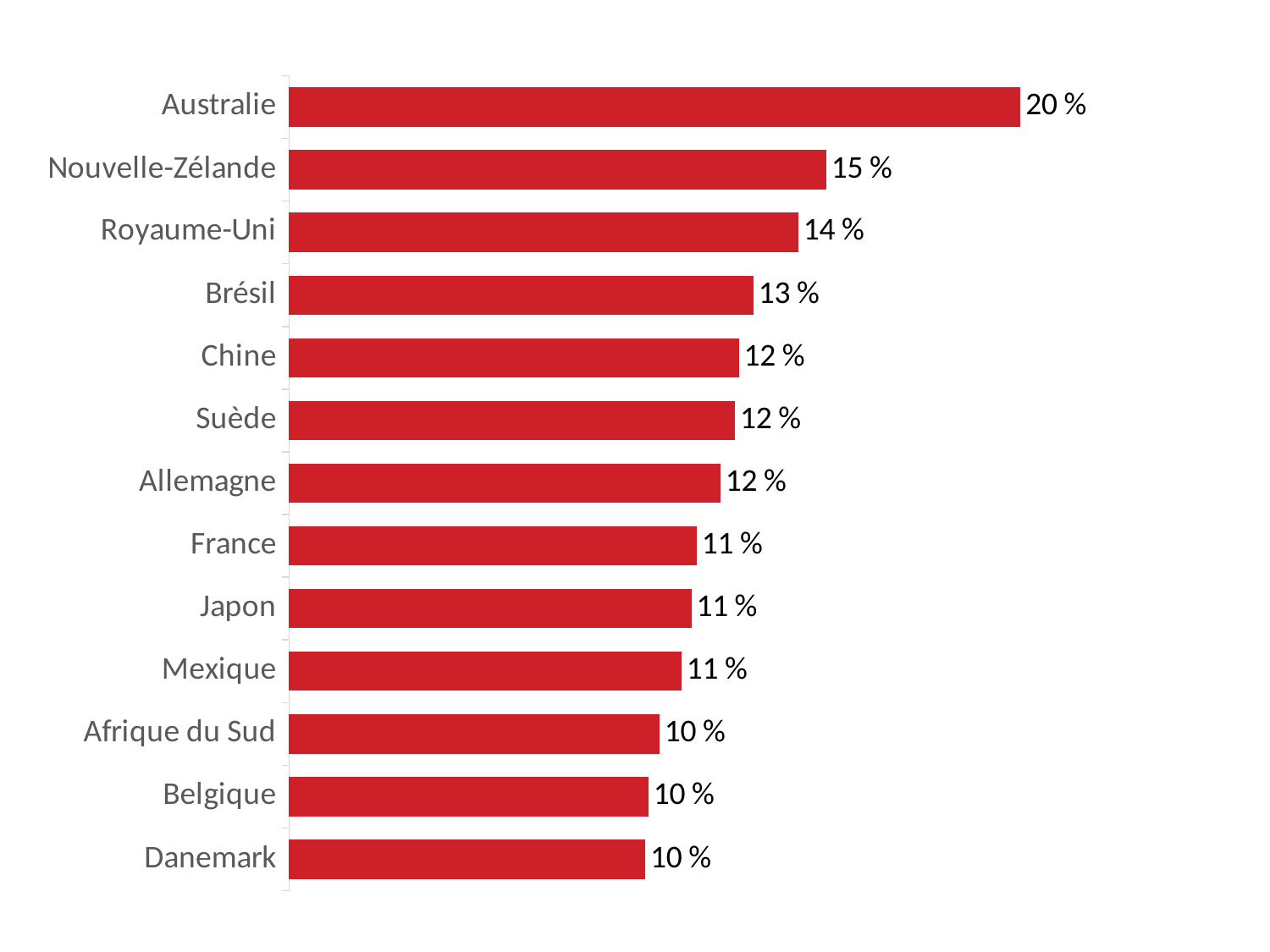
Which is larger, the value for Brésil or the value for France? Brésil What is the value for Royaume-Uni? 14 % What is the difference between the values for Royaume-Uni and Danemark? 4 % What colour are the bars in the chart? Red What is the value for Afrique du Sud? 10 % How many categories are shown in the chart? 13 What is the difference between the values for Australie and Nouvelle-Zélande? 5 % What is the value for Australie? 20 % Which is larger, the value for Nouvelle-Zélande or the value for Chine? Nouvelle-Zélande What kind of chart is this? Bar chart Which category has the highest value? Australie What is the value for Brésil? 13 %